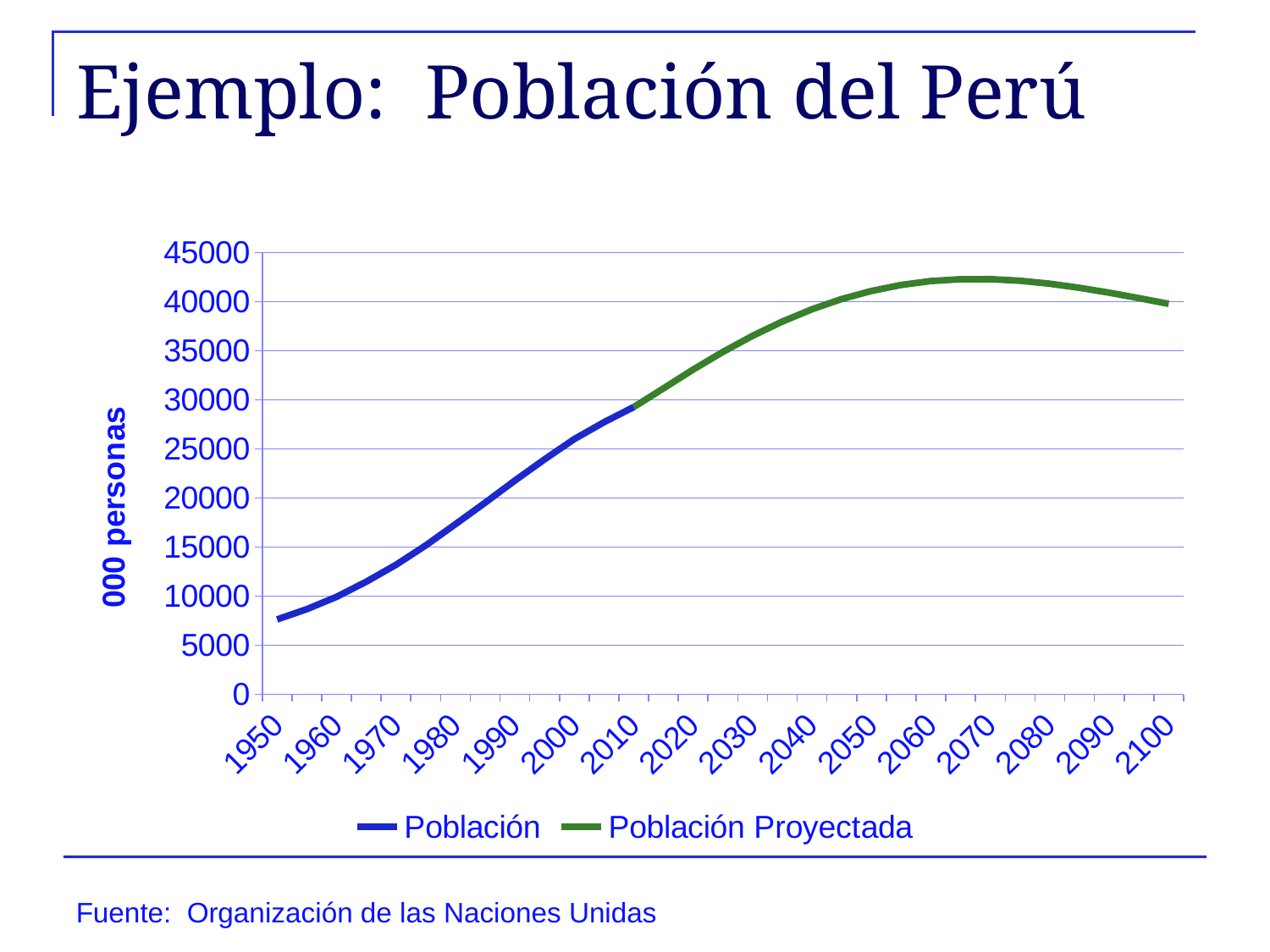
Around which year does the Población Proyectada series reach its highest value? 2070 How many year labels are shown along the x axis? 16 Is the value for Población in 1950 greater or less than 10000? less Is the value for Población in 1970 greater or less than 15000? less What are the two series named in the legend? Población and Población Proyectada What is the label on the vertical axis? 000 personas Is the value for Población Proyectada in 2020 greater or less than 30000? greater How many series does the legend list? 2 What kind of chart is shown on the slide? line chart Does the Población series rise or fall from 1950 to 2010? rise